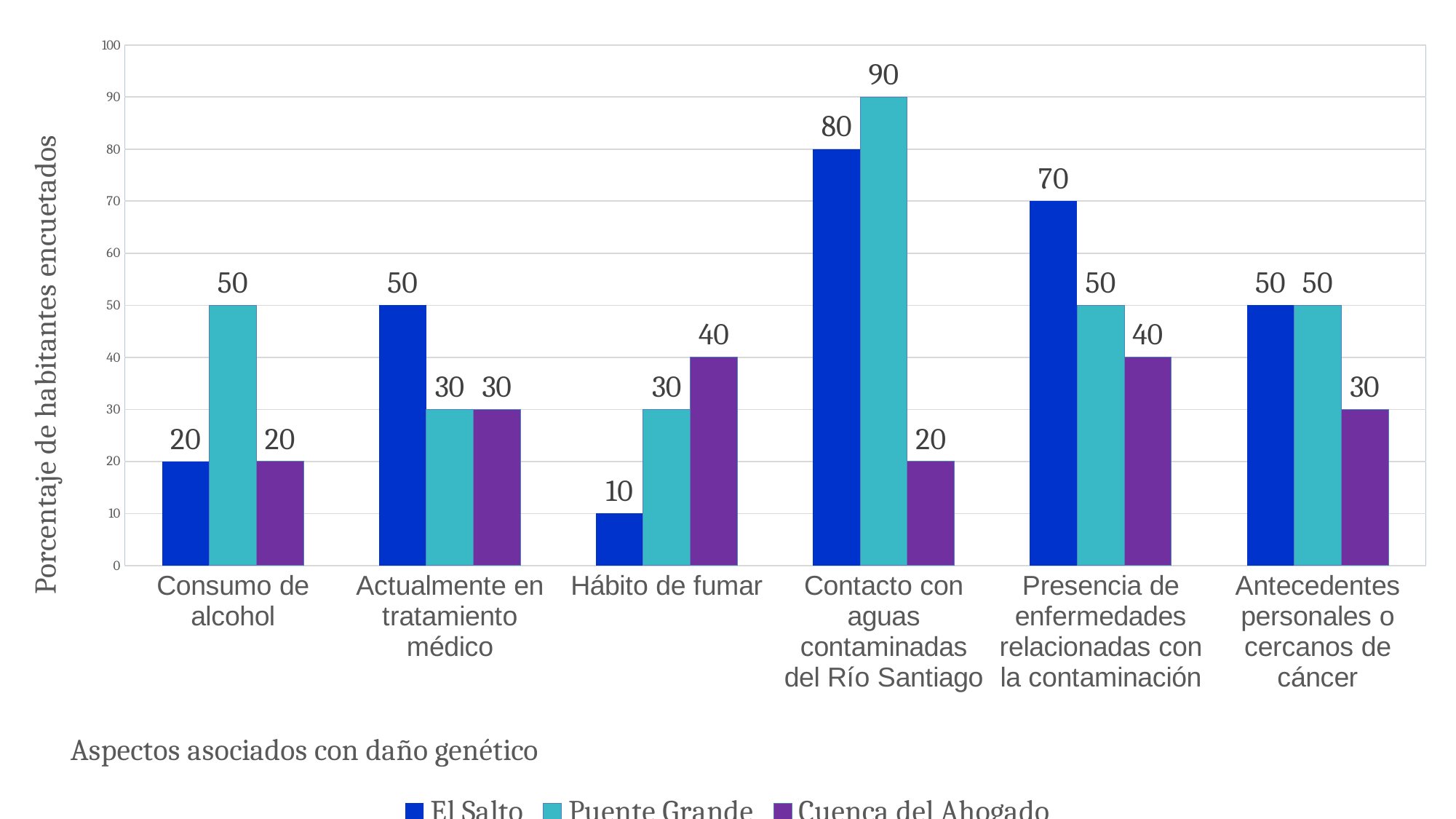
What is the value for Puente Grande in the 'Contacto con aguas contaminadas del Río Santiago' category? 90 How many series does the legend list? 3 What is the label of the y axis? Porcentaje de habitantes encuetados Which category has the lowest value for El Salto? Hábito de fumar In the 'Hábito de fumar' category, which series has the larger value, El Salto or Cuenca del Ahogado? Cuenca del Ahogado What kind of chart is shown on the slide? Bar chart Which category has the highest value for El Salto? Contacto con aguas contaminadas del Río Santiago How many categories are shown on the x axis? 6 What is the difference between the Puente Grande and Cuenca del Ahogado values in the 'Contacto con aguas contaminadas del Río Santiago' category? 70 What is the value for Cuenca del Ahogado in the 'Presencia de enfermedades relacionadas con la contaminación' category? 40 What is the value for El Salto in the 'Hábito de fumar' category? 10 Which series is shown in purple in the legend? Cuenca del Ahogado